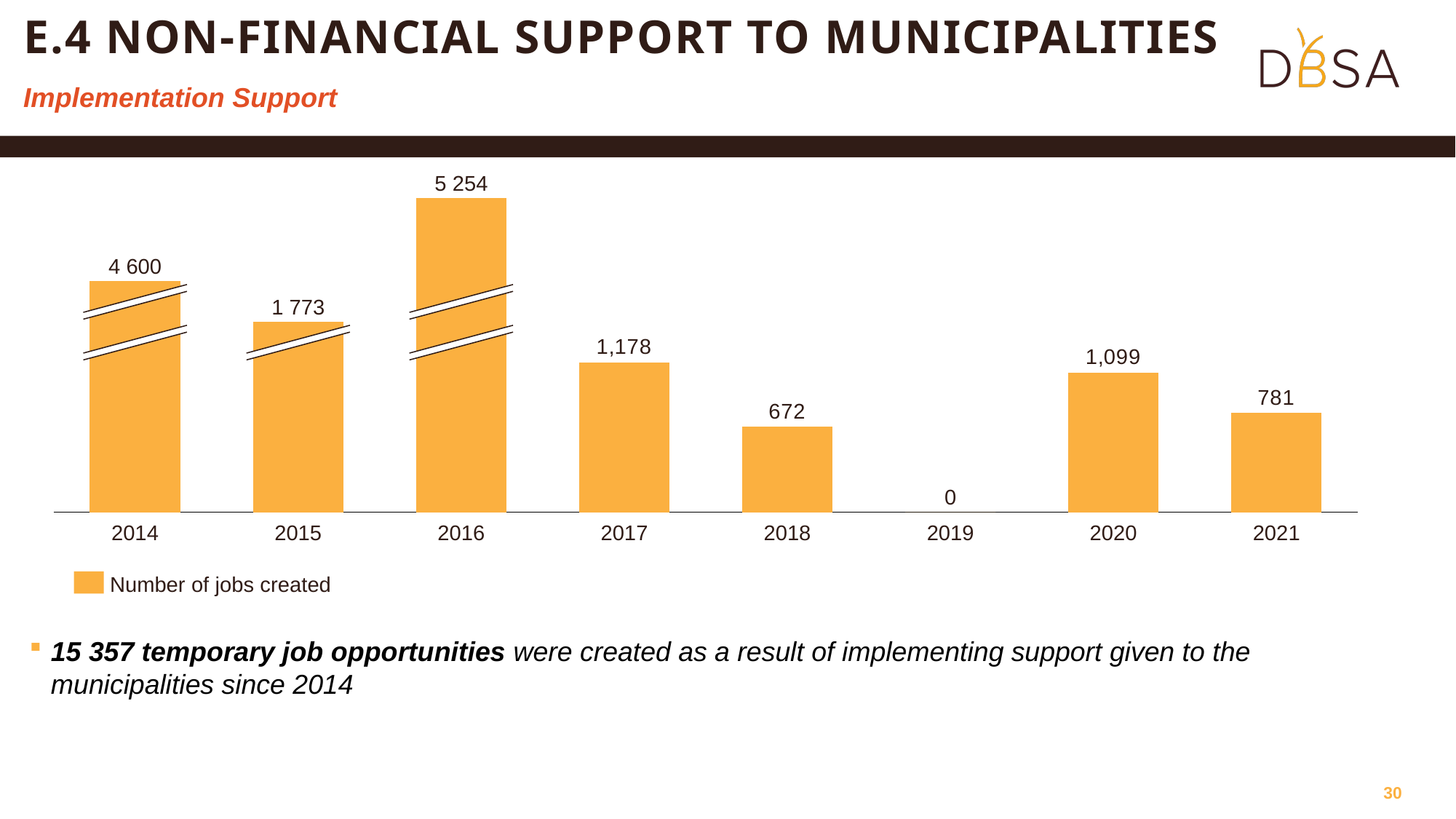
Which year has the highest number of jobs created? 2016 How many series does the chart legend list? 1 What is the number of jobs created in 2016? 5 254 What is the number of jobs created in 2018? 672 Which year has the lowest number of jobs created? 2019 What is the difference between the number of jobs created in 2017 and in 2018? 506 Do the values rise or fall from 2016 to 2019? Fall How many years are shown on the x axis of the chart? 8 What is the number of jobs created in 2021? 781 What kind of chart is shown on the slide? Bar chart Which year had more jobs created, 2014 or 2015? 2014 What is the difference between the number of jobs created in 2020 and in 2021? 318